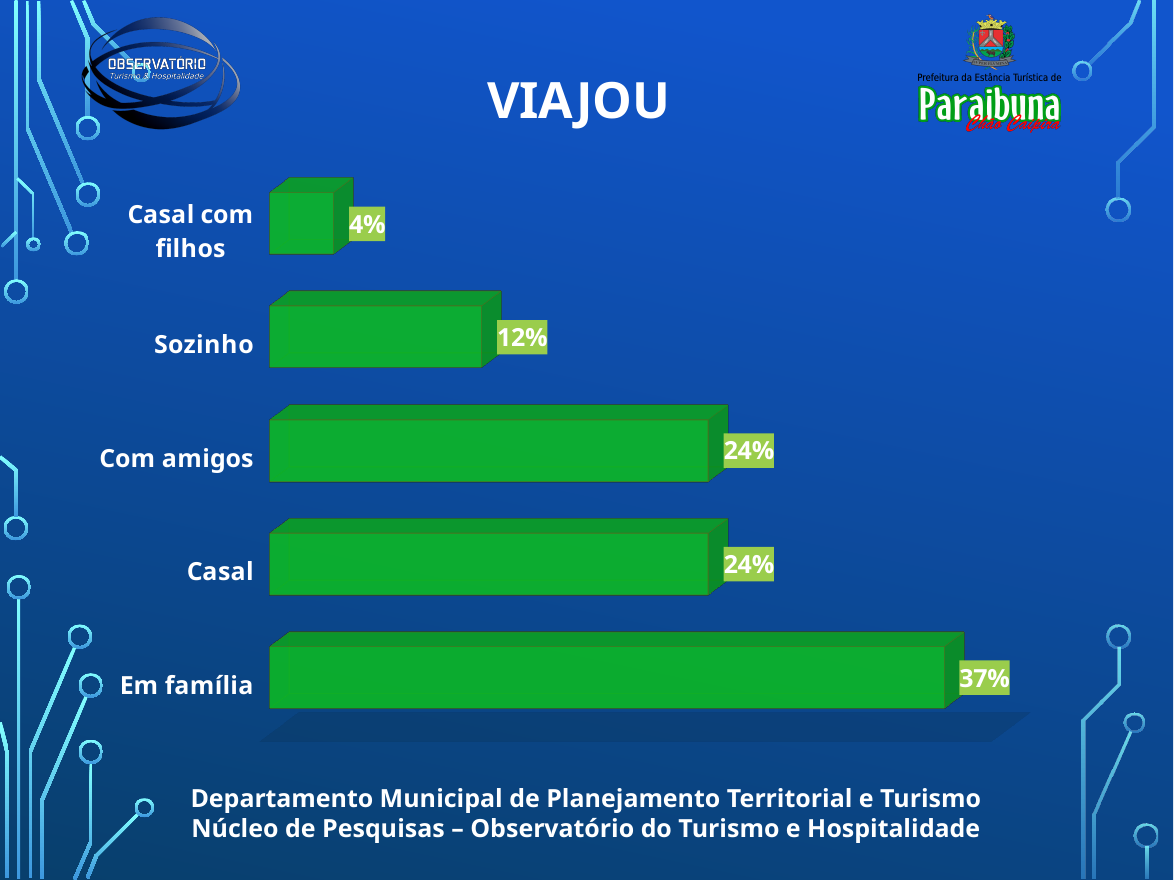
What is the difference between the values for Sozinho and Casal com filhos? 8% Which is larger, the value for Sozinho or the value for Com amigos? Com amigos What is the difference between the values for Em família and Casal? 13% Which category has the highest value? Em família What is the value for Com amigos? 24% What is the value for Sozinho? 12% What is the value for Casal com filhos? 4% How many categories are shown in the chart? 5 What is the title of the chart? VIAJOU What is the value for Em família? 37% What kind of chart is shown on the slide? Bar chart Which category has the lowest value? Casal com filhos